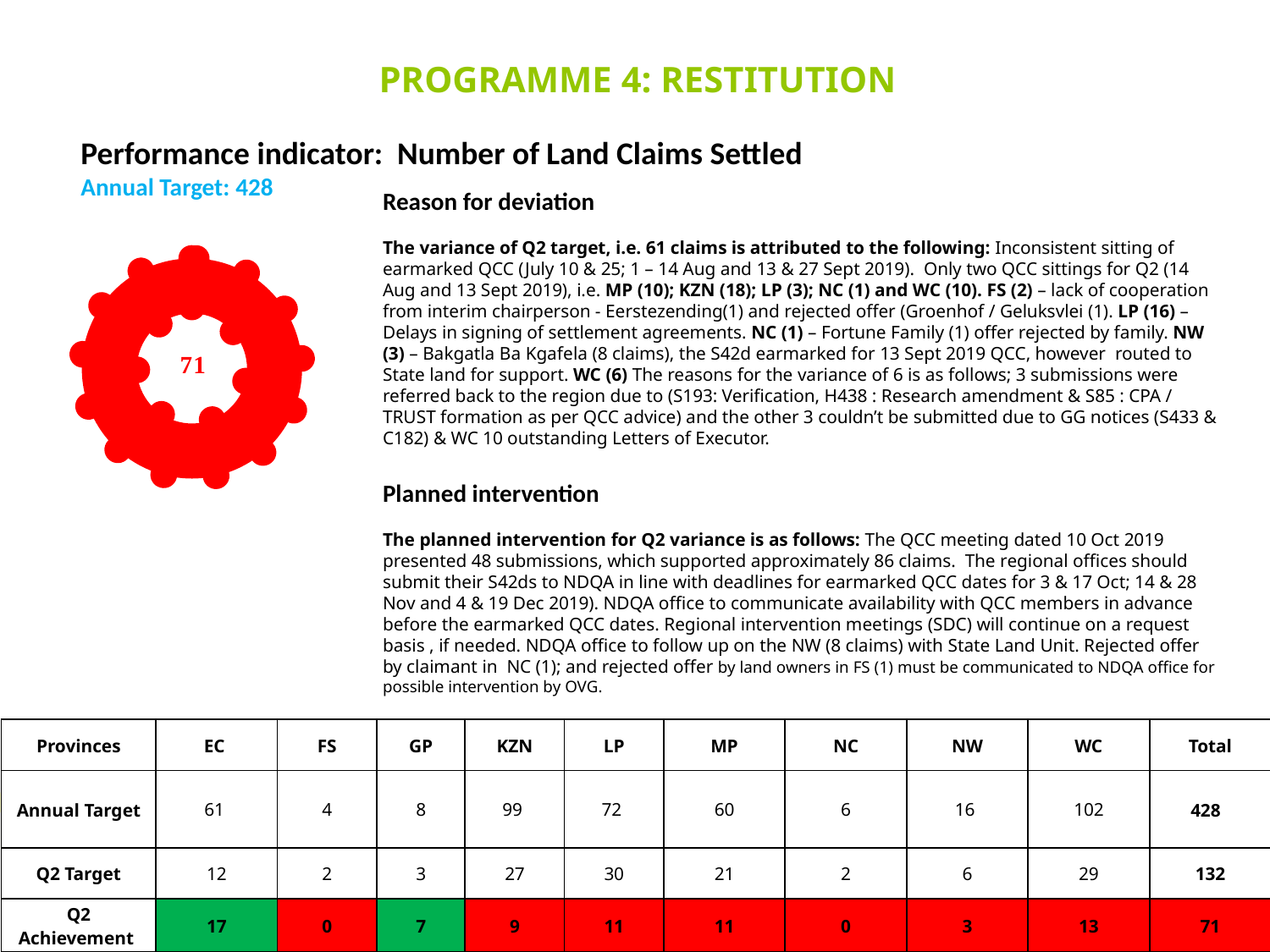
What colour is the doughnut chart? red What value is printed in the centre of the doughnut chart? 71 What kind of chart is shown on the left of the slide? doughnut chart How many data labels are printed on the doughnut chart? 0